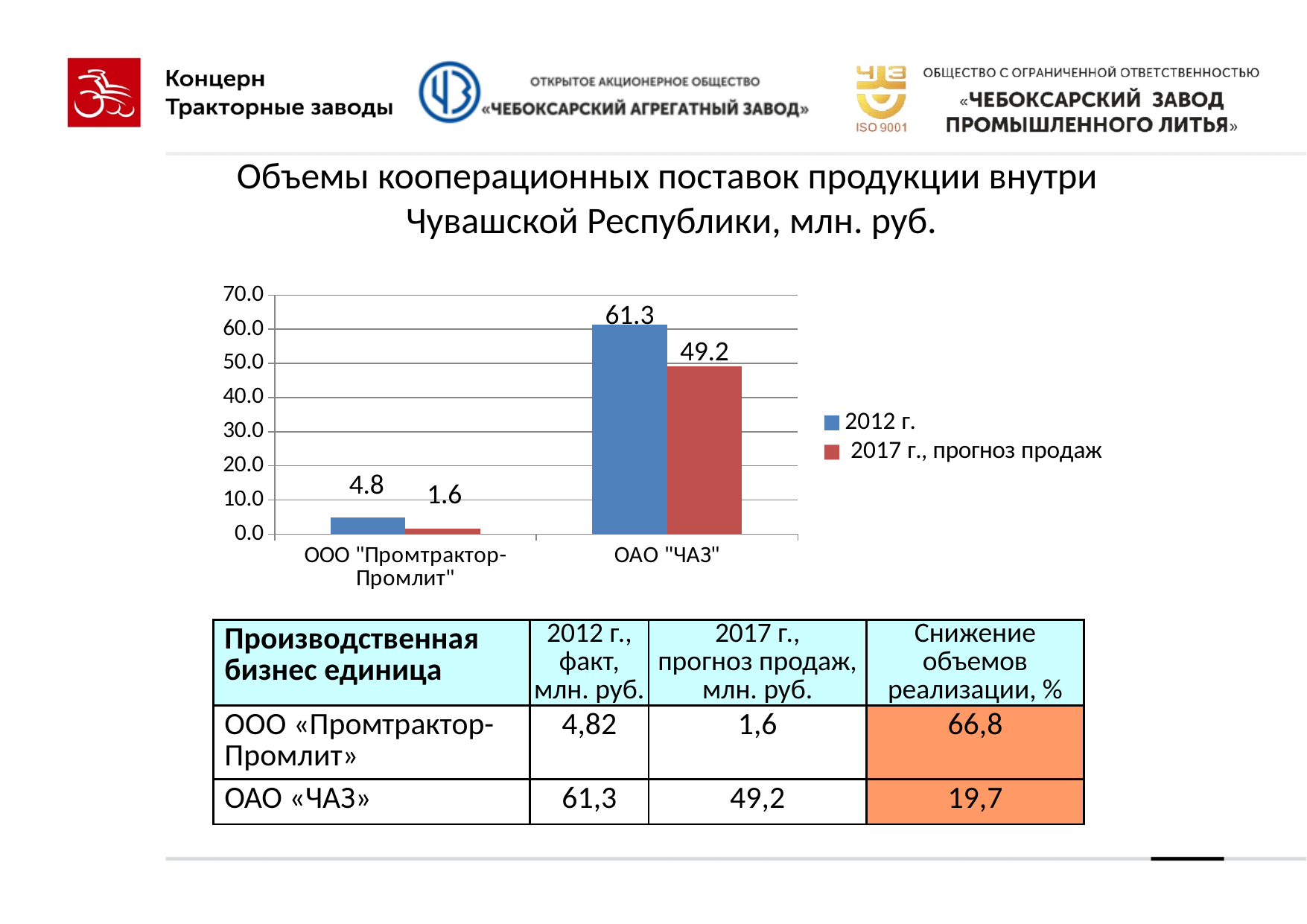
What is the 2017 г., прогноз продаж value for ОАО "ЧАЗ" in the chart? 49.2 What is the 2012 г. value for ООО "Промтрактор-Промлит" in the chart? 4.8 Is the 2012 г. value for ОАО "ЧАЗ" greater or less than 50.0? greater Which category has the highest 2012 г. value in the chart? ОАО "ЧАЗ" What is the difference between the 2012 г. and 2017 г., прогноз продаж values for ОАО "ЧАЗ" in the chart? 12.1 What kind of chart is shown on the slide? Bar chart What is the 2012 г. value for ОАО "ЧАЗ" in the chart? 61.3 What is the 2017 г., прогноз продаж value for ООО "Промтрактор-Промлит" in the chart? 1.6 How many categories are shown on the x axis of the chart? 2 Which category has the lowest 2017 г., прогноз продаж value in the chart? ООО "Промтрактор-Промлит" How many series does the chart legend list? 2 For ООО "Промтрактор-Промлит", which is larger in the chart: the 2012 г. value or the 2017 г., прогноз продаж value? 2012 г.